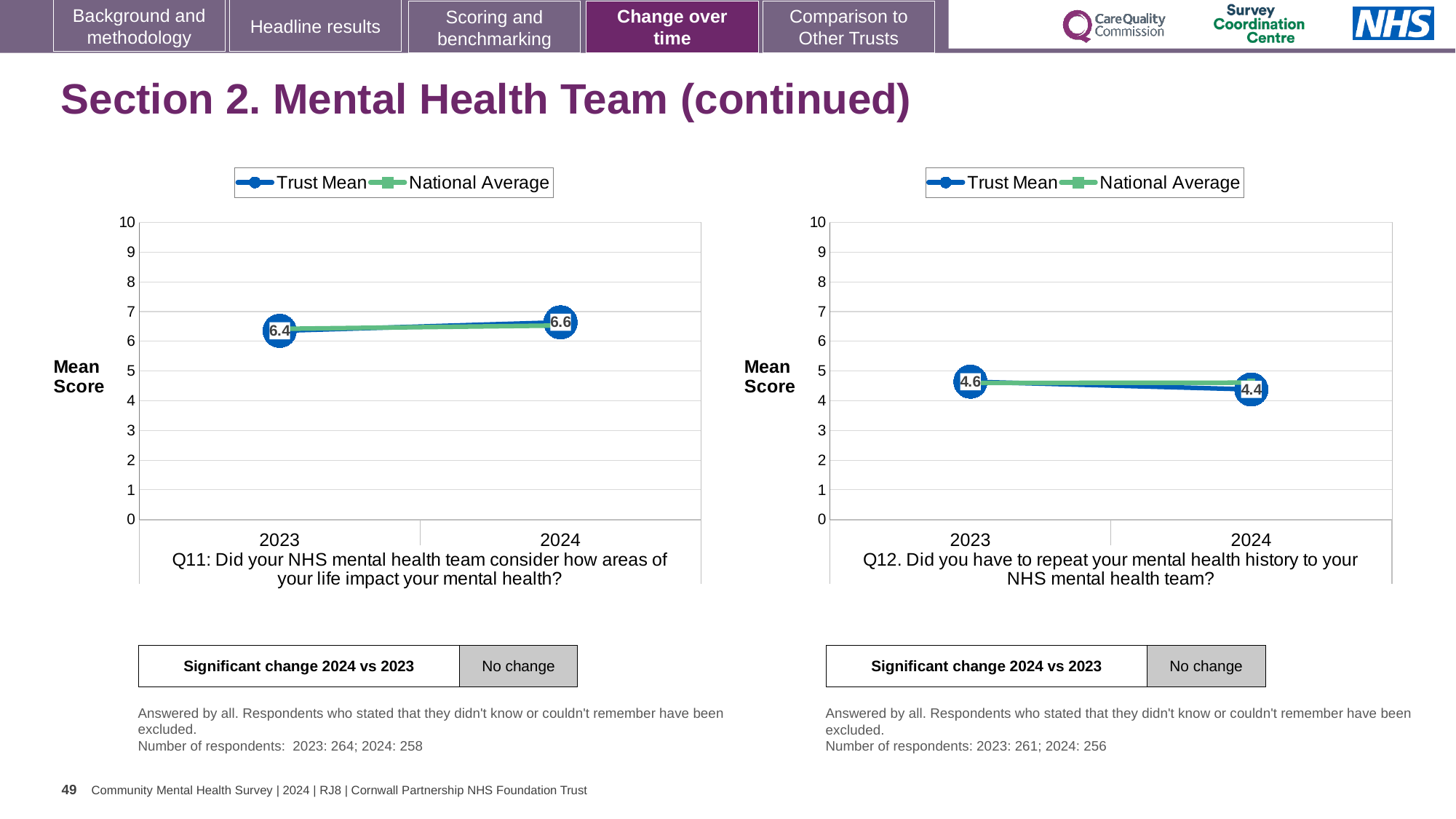
In the Q11 chart on the left, does the Trust Mean rise or fall from 2023 to 2024? rise In the Q12 chart on the right, does the Trust Mean rise or fall from 2023 to 2024? fall In the Q11 chart on the left, by how much did the Trust Mean change from 2023 to 2024? 0.2 In the Q12 chart on the right, what is the Trust Mean score for 2024? 4.4 Which is larger: the 2024 Trust Mean in the Q11 chart on the left or the 2024 Trust Mean in the Q12 chart on the right? Q11 chart (6.6) In the Q12 chart on the right, what is the Trust Mean score for 2023? 4.6 In the Q11 chart on the left, what is the Trust Mean score for 2024? 6.6 How many years are shown on the x axis of the Q12 chart on the right? 2 In the Q12 chart on the right, is the National Average for 2024 greater or less than 6? less In the Q11 chart on the left, what is the Trust Mean score for 2023? 6.4 How many series does the legend of the Q11 chart on the left list? 2 What kind of chart is the Q12 chart on the right? line chart